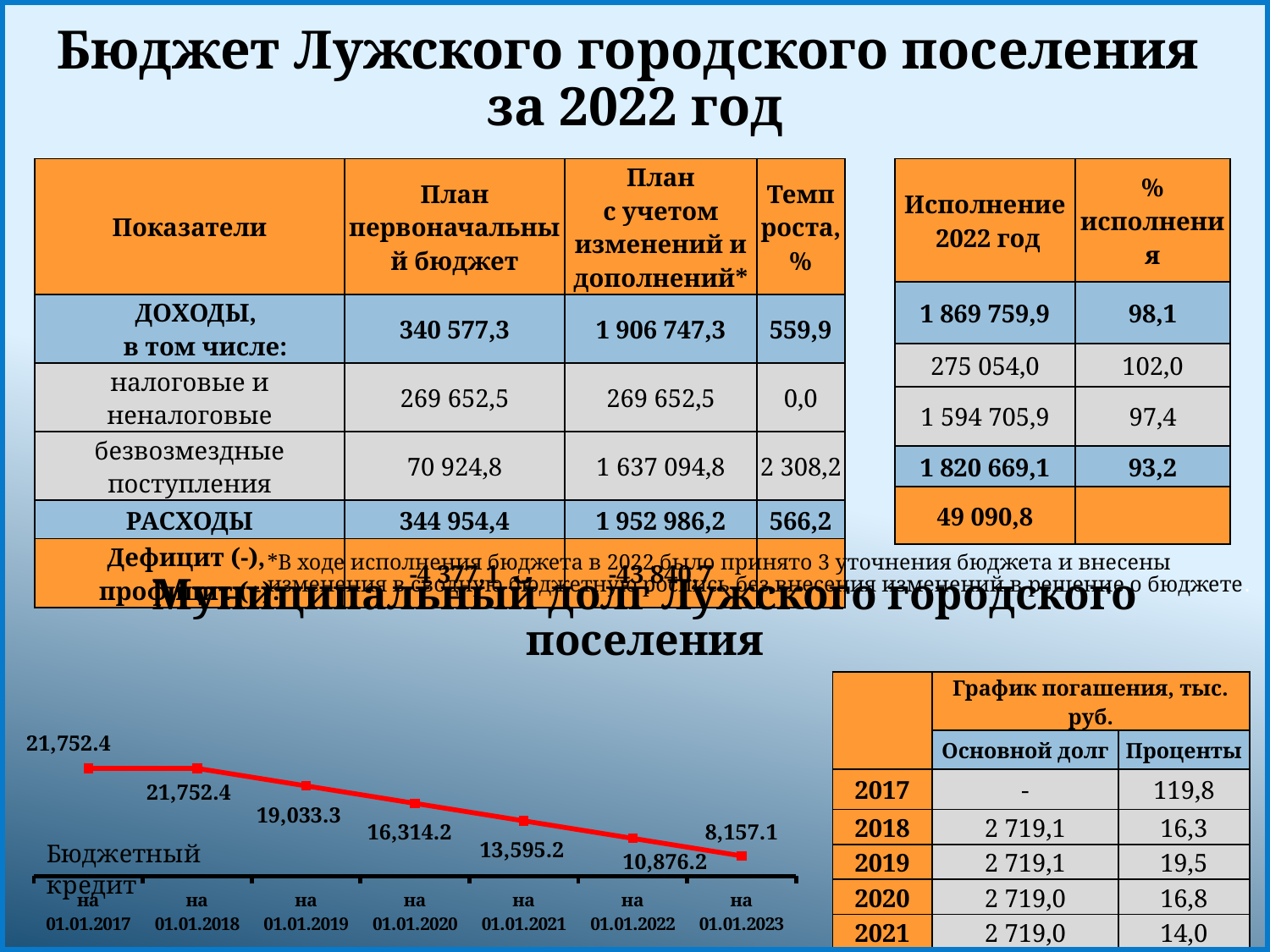
In the line chart at the bottom left, which is larger: the value for на 01.01.2020 or the value for на 01.01.2022? на 01.01.2020 In the line chart at the bottom left, what is the value for на 01.01.2023? 8,157.1 In the line chart at the bottom left, do the values rise or fall from на 01.01.2018 to на 01.01.2023? fall In the line chart at the bottom left, what is the difference between the values for на 01.01.2017 and на 01.01.2023? 13,595.3 What kind of chart is shown at the bottom left of the slide? line chart How many data points are plotted in the line chart at the bottom left? 7 In the line chart at the bottom left, what is the value for на 01.01.2017? 21,752.4 In the line chart at the bottom left, what is the value for на 01.01.2019? 19,033.3 In the line chart at the bottom left, which date has the lowest value? на 01.01.2023 In the line chart at the bottom left, what is the difference between the values for на 01.01.2019 and на 01.01.2020? 2,719.1 In the line chart at the bottom left, what is the value for на 01.01.2021? 13,595.2